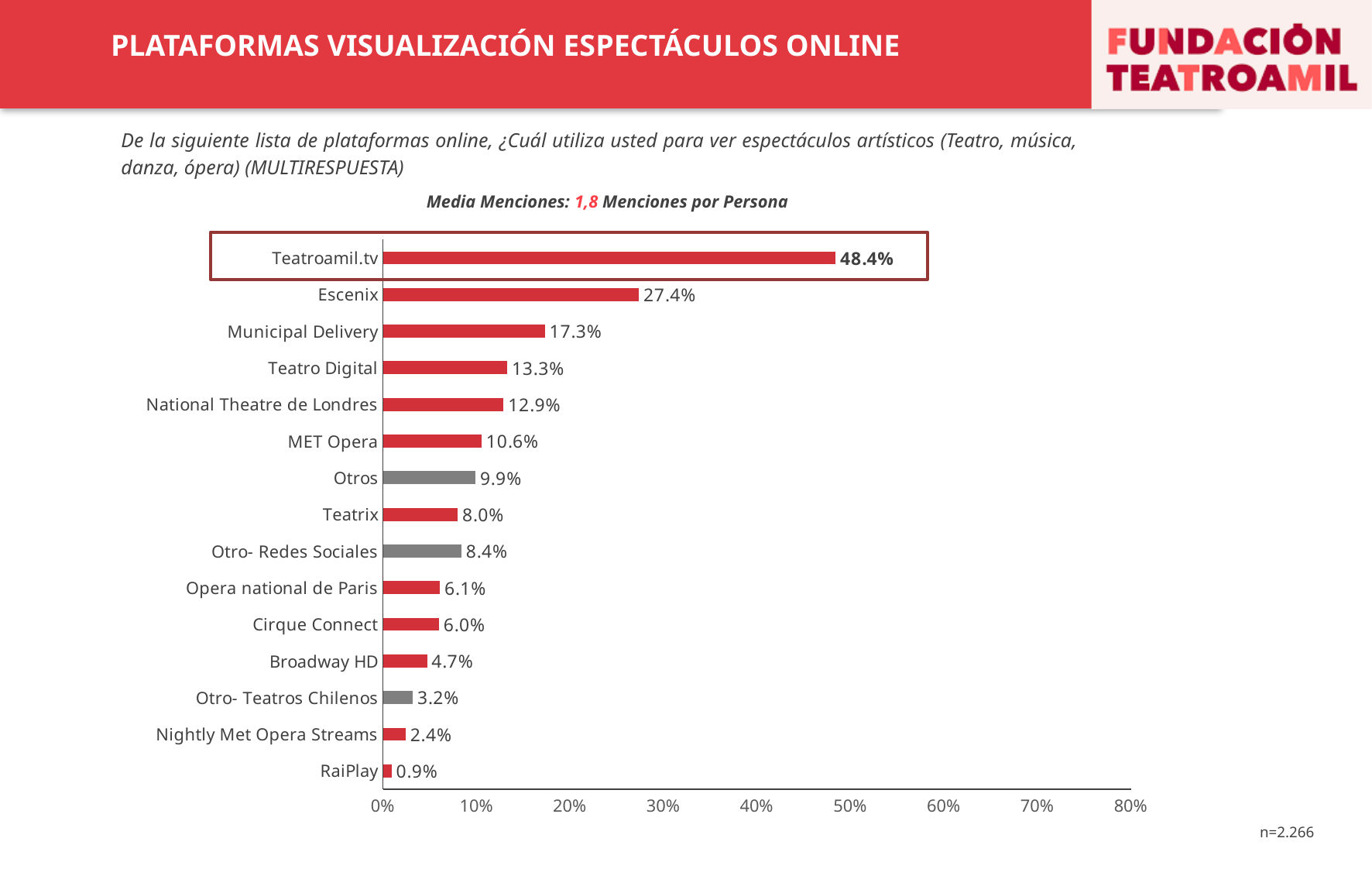
What kind of chart is shown on the slide? bar chart What is the difference between the values for Teatro Digital and National Theatre de Londres? 0.4% Is the value for Escenix greater or less than 30%? less What is the 'Media Menciones' (average mentions per person) stated above the chart? 1,8 Which platform has the highest value? Teatroamil.tv Which platform has the lowest value? RaiPlay What is the value for Municipal Delivery? 17.3% What is the difference between the values for Teatroamil.tv and Escenix? 21.0% What is the value for Nightly Met Opera Streams? 2.4% Which is larger, the value for Teatrix or the value for Otro- Redes Sociales? Otro- Redes Sociales How many categories are shown in the chart? 15 What is the value for Teatroamil.tv? 48.4%